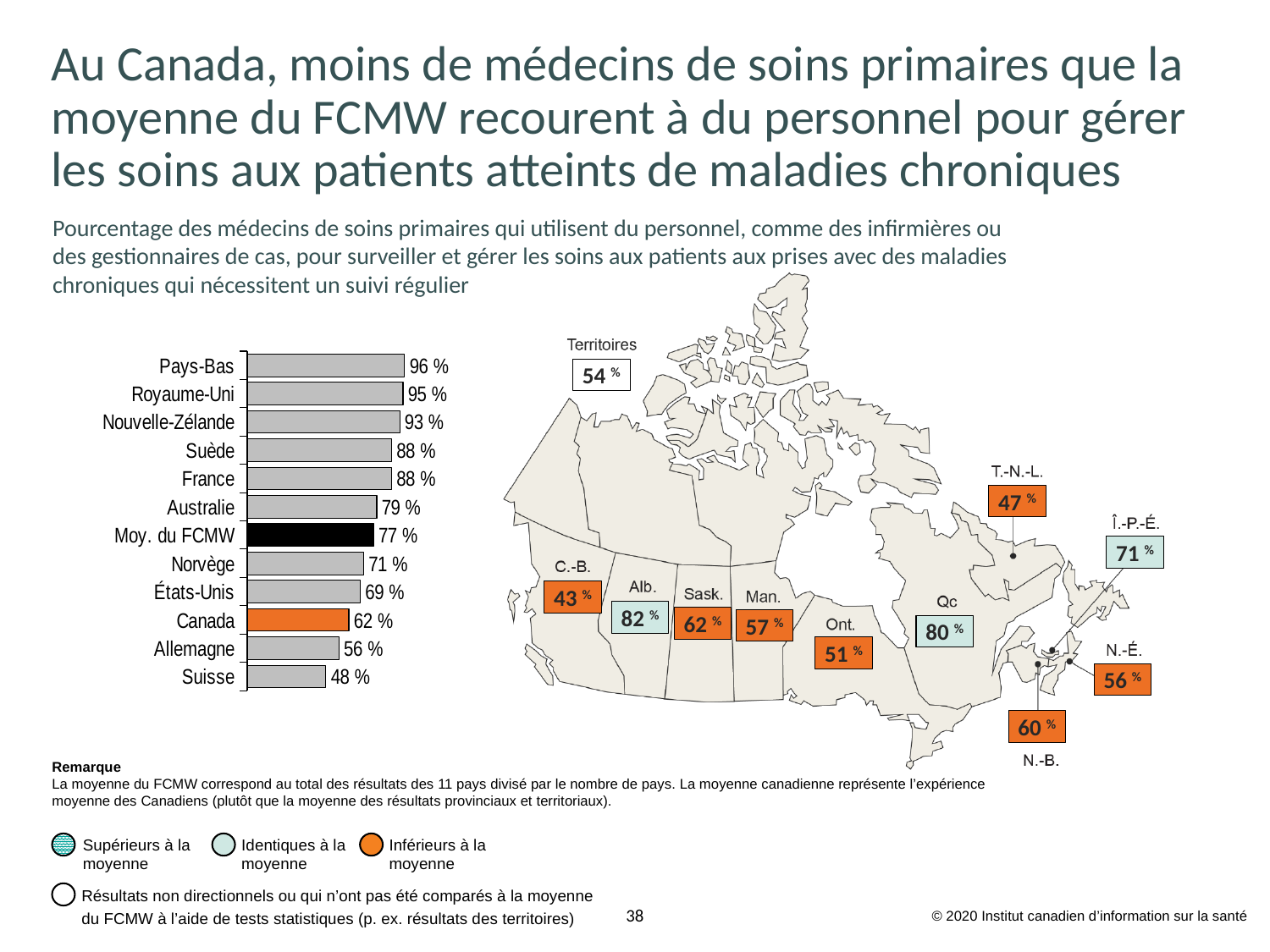
How many countries or categories are shown in the bar chart? 12 In the bar chart, which country has the highest value? Pays-Bas In the bar chart, which country has the lowest value? Suisse What type of chart is used to show the country values on the left of the slide? Bar chart In the bar chart, what is the difference between the values for Moy. du FCMW and Canada? 15 % In the bar chart, what is the value for Moy. du FCMW? 77 % In the bar chart, which is larger, the value for Australie or the value for Norvège? Australie In the bar chart, which bar is coloured orange? Canada In the bar chart, what is the difference between the values for Pays-Bas and Suisse? 48 % In the bar chart, what is the value for Allemagne? 56 % In the bar chart, what is the value for Canada? 62 % On the map of Canada, what is the value shown for Qc? 80 %